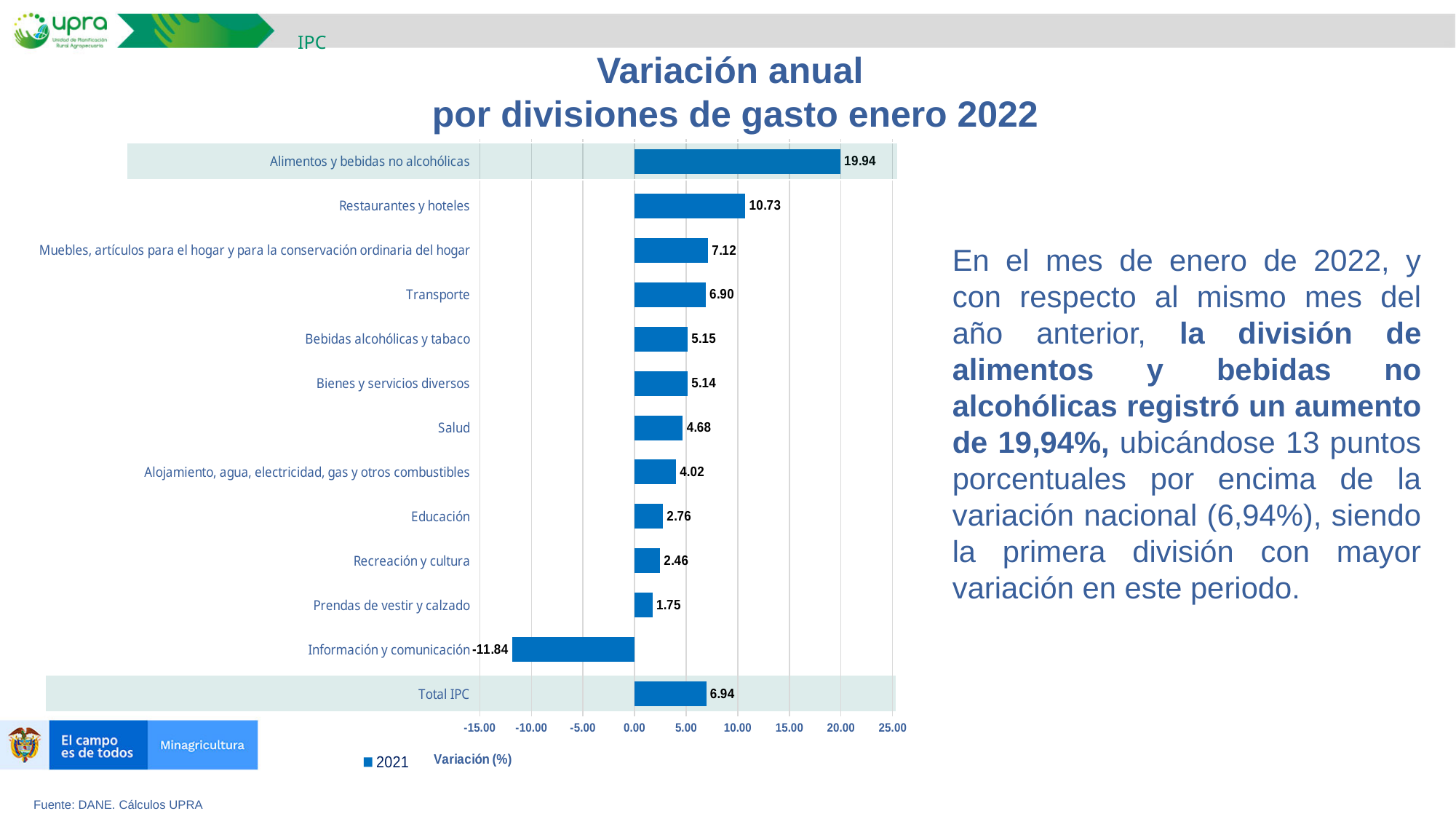
Is the value for Restaurantes y hoteles greater or less than 10.00? greater What is the value for Alimentos y bebidas no alcohólicas? 19.94 What is the value for Información y comunicación? -11.84 What series does the legend list? 2021 What is the difference between the values for Alimentos y bebidas no alcohólicas and Restaurantes y hoteles? 9.21 Which is larger, the value for Educación or the value for Recreación y cultura? Educación What is the value for Total IPC? 6.94 Which category has the highest value? Alimentos y bebidas no alcohólicas How many categories are shown in the chart? 13 What is the value for Transporte? 6.90 Which category has the lowest value? Información y comunicación What kind of chart is shown on the slide? Bar chart